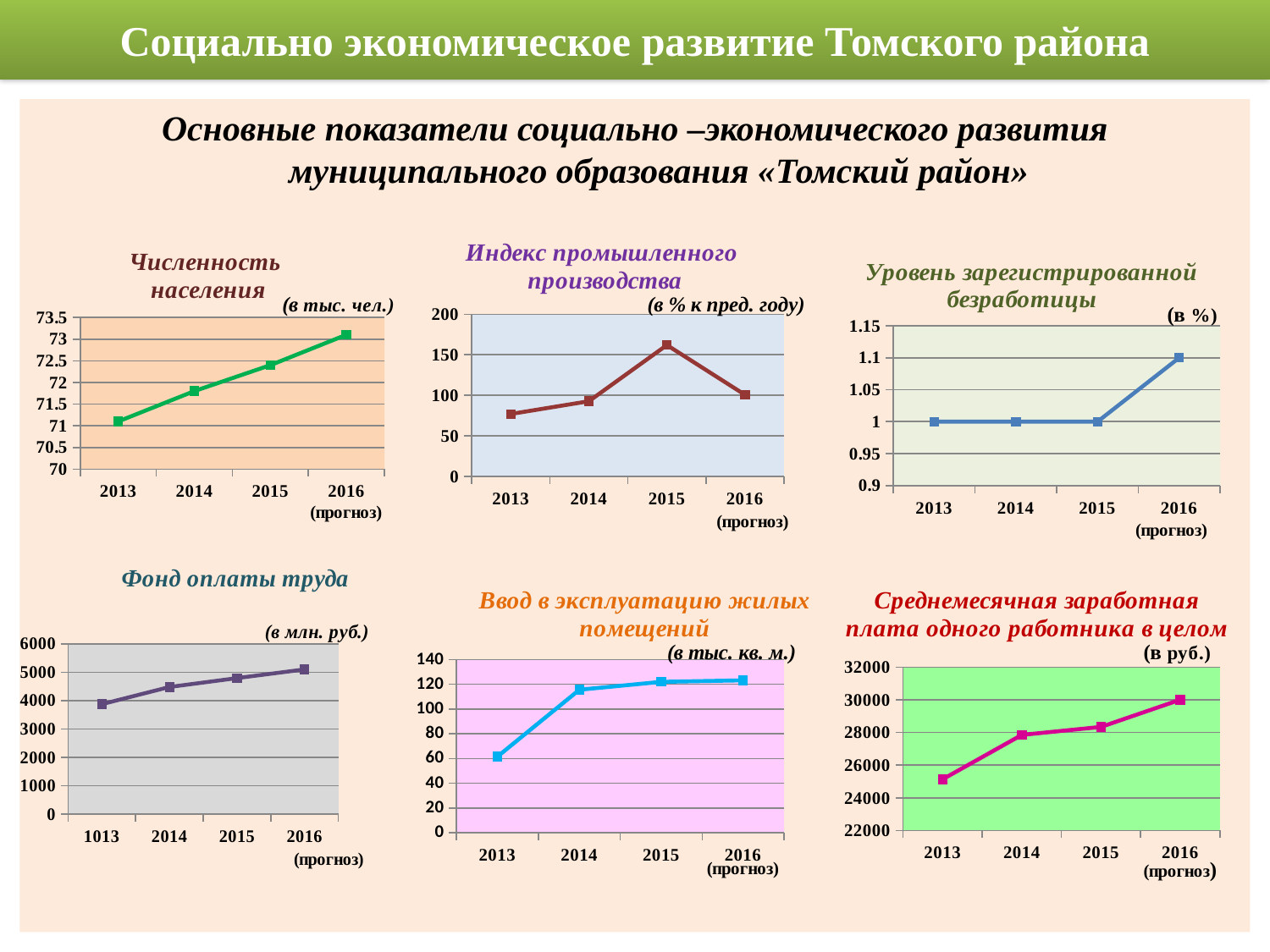
On the "Уровень зарегистрированной безработицы" chart, what is the value for 2014? 1 What kind of chart is the "Численность населения" chart? line chart What unit is shown for the "Фонд оплаты труда" chart? в млн. руб. How many years are plotted on the "Фонд оплаты труда" chart? 4 On the "Ввод в эксплуатацию жилых помещений" chart, is the value for 2013 greater or less than 80? less On the "Уровень зарегистрированной безработицы" chart, what is the value for 2016 (прогноз)? 1.1 On the "Численность населения" chart, do the values rise or fall from 2013 to 2016? rise On the "Среднемесячная заработная плата одного работника в целом" chart, is the value for 2013 greater or less than 26000? less On the "Ввод в эксплуатацию жилых помещений" chart, which is larger, the value for 2013 or the value for 2014? 2014 On the "Индекс промышленного производства" chart, which year has the highest value? 2015 On the "Индекс промышленного производства" chart, which year has the lowest value? 2013